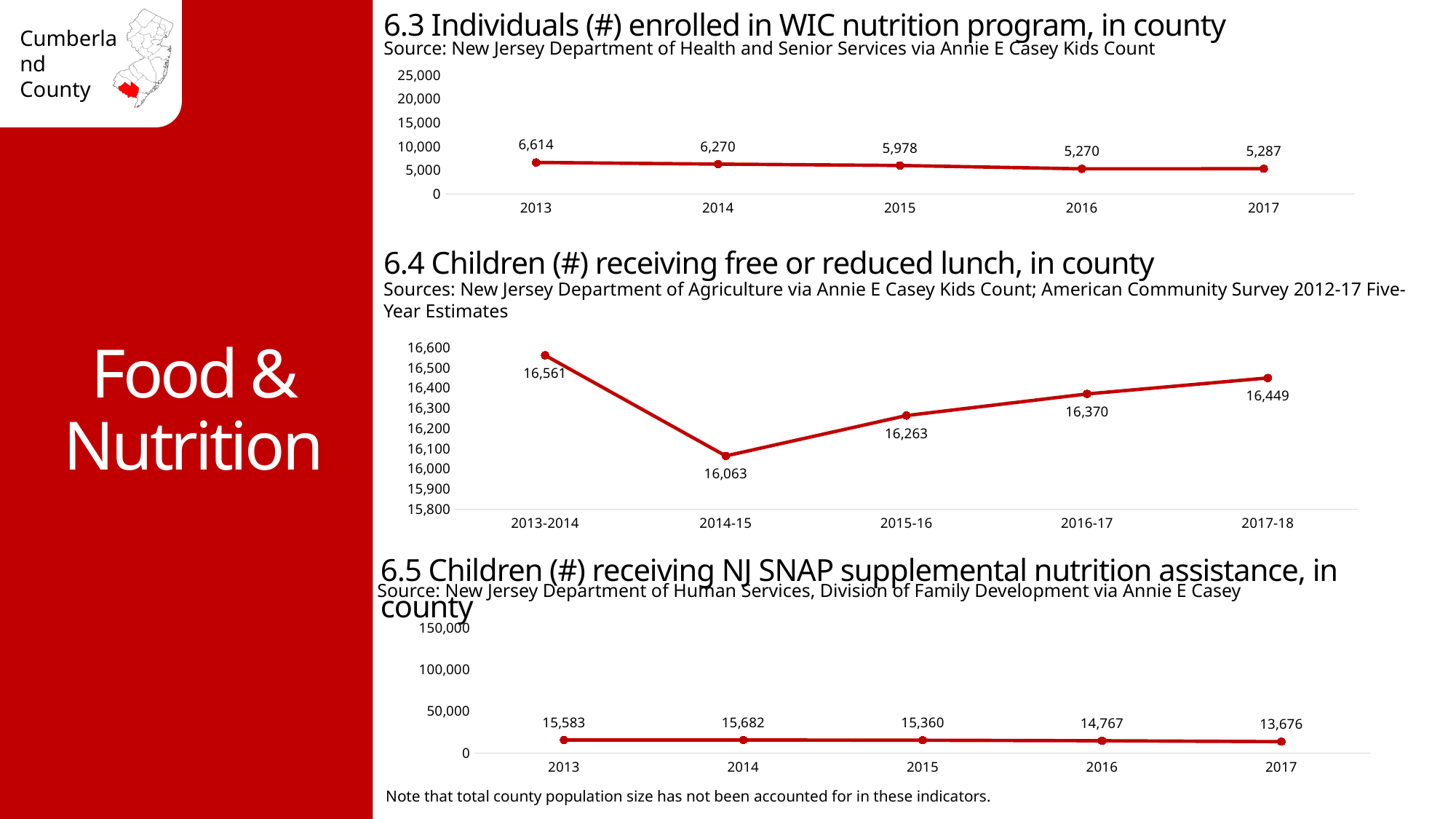
In the chart '6.4 Children (#) receiving free or reduced lunch, in county', which school year has the highest value? 2013-2014 In the chart '6.5 Children (#) receiving NJ SNAP supplemental nutrition assistance, in county', which year has the highest value? 2014 In the chart '6.4 Children (#) receiving free or reduced lunch, in county', which is larger, the value for 2016-17 or 2017-18? 2017-18 In the chart '6.3 Individuals (#) enrolled in WIC nutrition program, in county', how many years are plotted? 5 In the chart '6.3 Individuals (#) enrolled in WIC nutrition program, in county', what is the difference between the 2013 and 2017 values? 1,327 In the chart '6.5 Children (#) receiving NJ SNAP supplemental nutrition assistance, in county', what is the value for 2016? 14,767 In the chart '6.4 Children (#) receiving free or reduced lunch, in county', what is the value for 2014-15? 16,063 In the chart '6.3 Individuals (#) enrolled in WIC nutrition program, in county', which year has the lowest value? 2016 In the chart '6.4 Children (#) receiving free or reduced lunch, in county', what is the difference between the 2017-18 and 2015-16 values? 186 In the chart '6.3 Individuals (#) enrolled in WIC nutrition program, in county', what is the value for 2013? 6,614 In the chart '6.5 Children (#) receiving NJ SNAP supplemental nutrition assistance, in county', do the values rise or fall from 2014 to 2017? fall What kind of chart is '6.5 Children (#) receiving NJ SNAP supplemental nutrition assistance, in county'? line chart